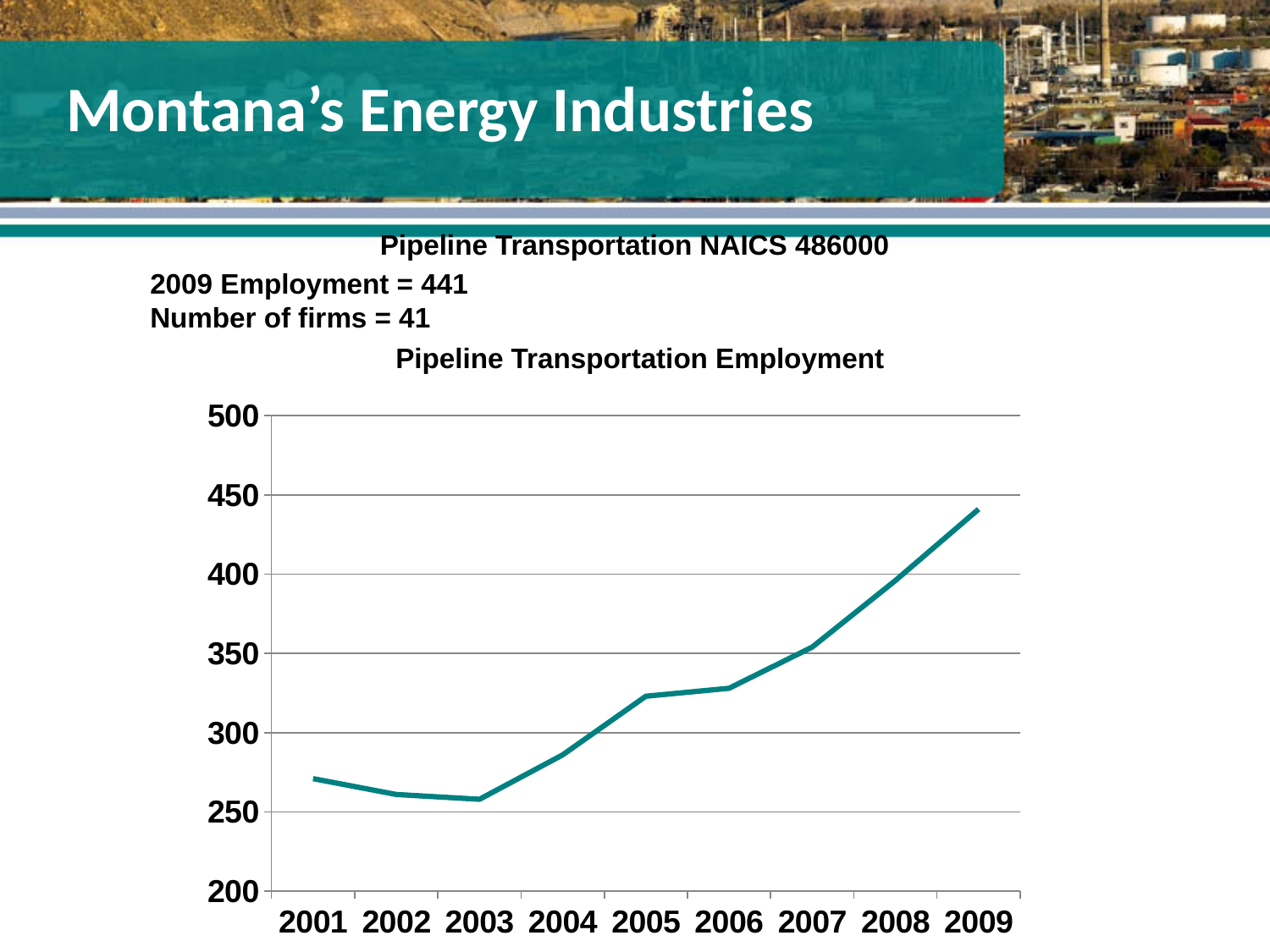
Is the value for 2001 greater or less than 300? less Is the value for 2004 greater or less than 300? less What is the title of the chart? Pipeline Transportation Employment Is the value for 2005 greater or less than 300? greater Which year has the larger employment value, 2003 or 2005? 2005 What kind of chart is shown on the slide? line chart How many years are plotted on the x axis of the chart? 9 Does pipeline transportation employment rise or fall between 2003 and 2009? rise What is the pipeline transportation employment value for 2009? 441 What is the lowest value shown on the y axis of the chart? 200 Which year has the highest pipeline transportation employment? 2009